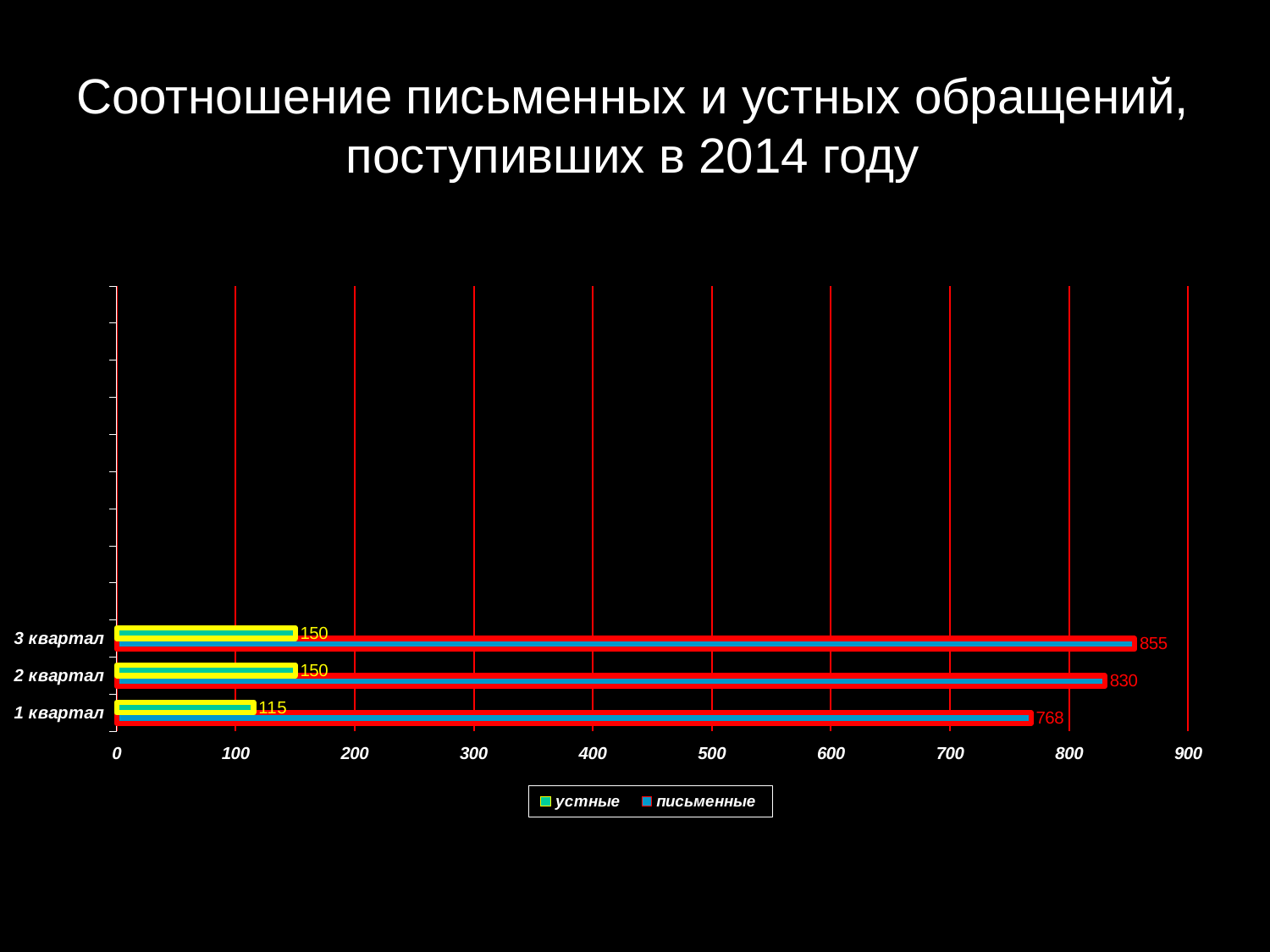
What is the value for устные in 2 квартал? 150 What is the value for устные in 1 квартал? 115 How many quarters are shown on the chart? 3 What is the value for письменные in 2 квартал? 830 What is the value for письменные in 3 квартал? 855 What is the difference between письменные and устные in 1 квартал? 653 What is the difference between письменные in 3 квартал and 2 квартал? 25 Which quarter has the lowest value for устные? 1 квартал Which quarter has the highest value for письменные? 3 квартал Which is larger: письменные in 1 квартал or письменные in 2 квартал? 2 квартал What kind of chart is shown on the slide? bar chart How many series does the legend list? 2